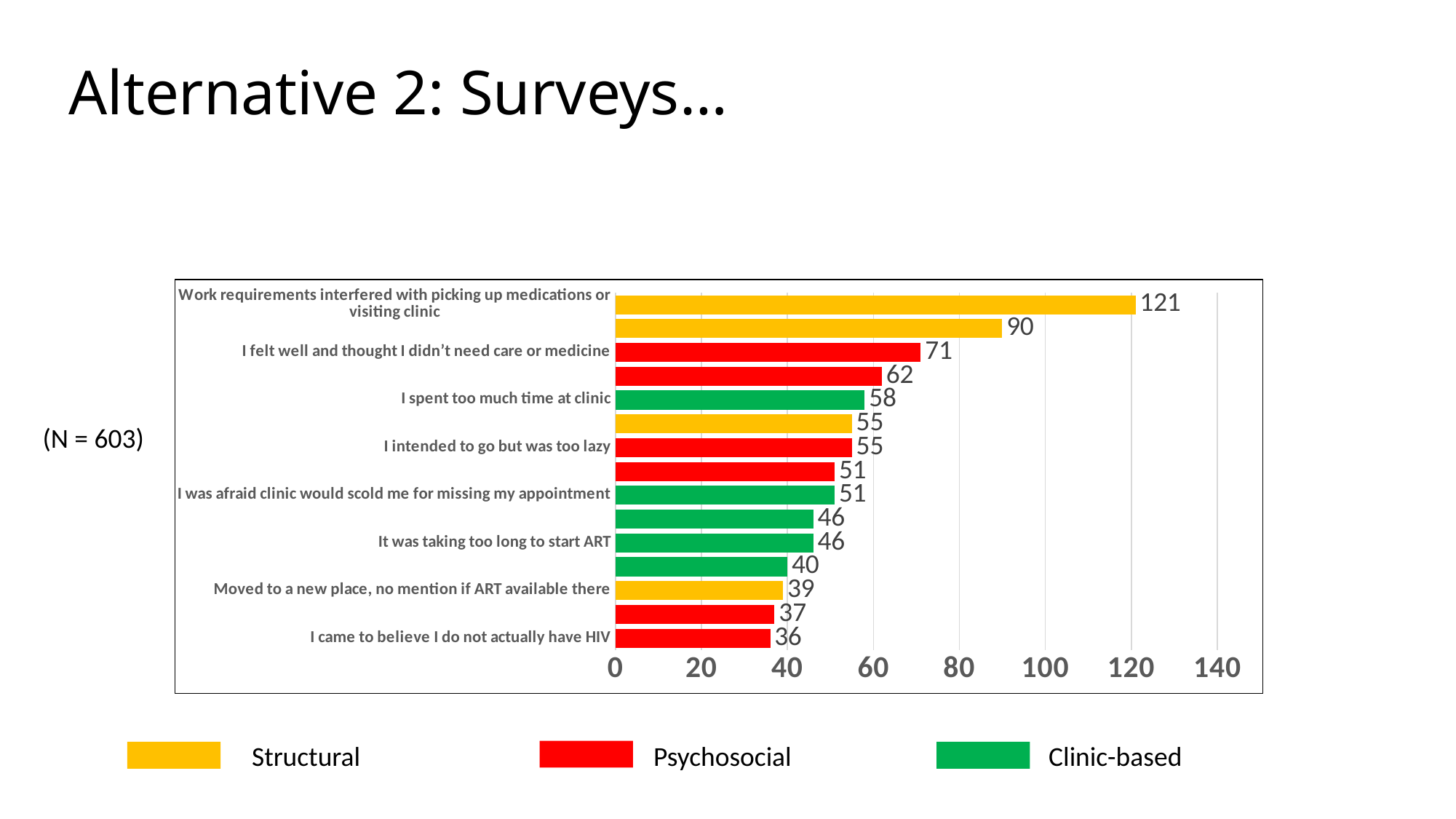
What is the value for 'I spent too much time at clinic'? 58 Which labelled reason has the lowest value? I came to believe I do not actually have HIV What is the value for 'Work requirements interfered with picking up medications or visiting clinic'? 121 Is the value for 'I was afraid clinic would scold me for missing my appointment' greater or less than 40? greater What is the difference between the values for 'Work requirements interfered with picking up medications or visiting clinic' and 'I felt well and thought I didn't need care or medicine'? 50 Which labelled reason has the highest value? Work requirements interfered with picking up medications or visiting clinic What is the value for 'I came to believe I do not actually have HIV'? 36 Which is larger: the value for 'I intended to go but was too lazy' or for 'It was taking too long to start ART'? I intended to go but was too lazy How many bars are plotted in the chart? 15 How many categories does the legend list? 3 What is the value for 'I felt well and thought I didn't need care or medicine'? 71 What colour represents the Psychosocial category in the legend? Red